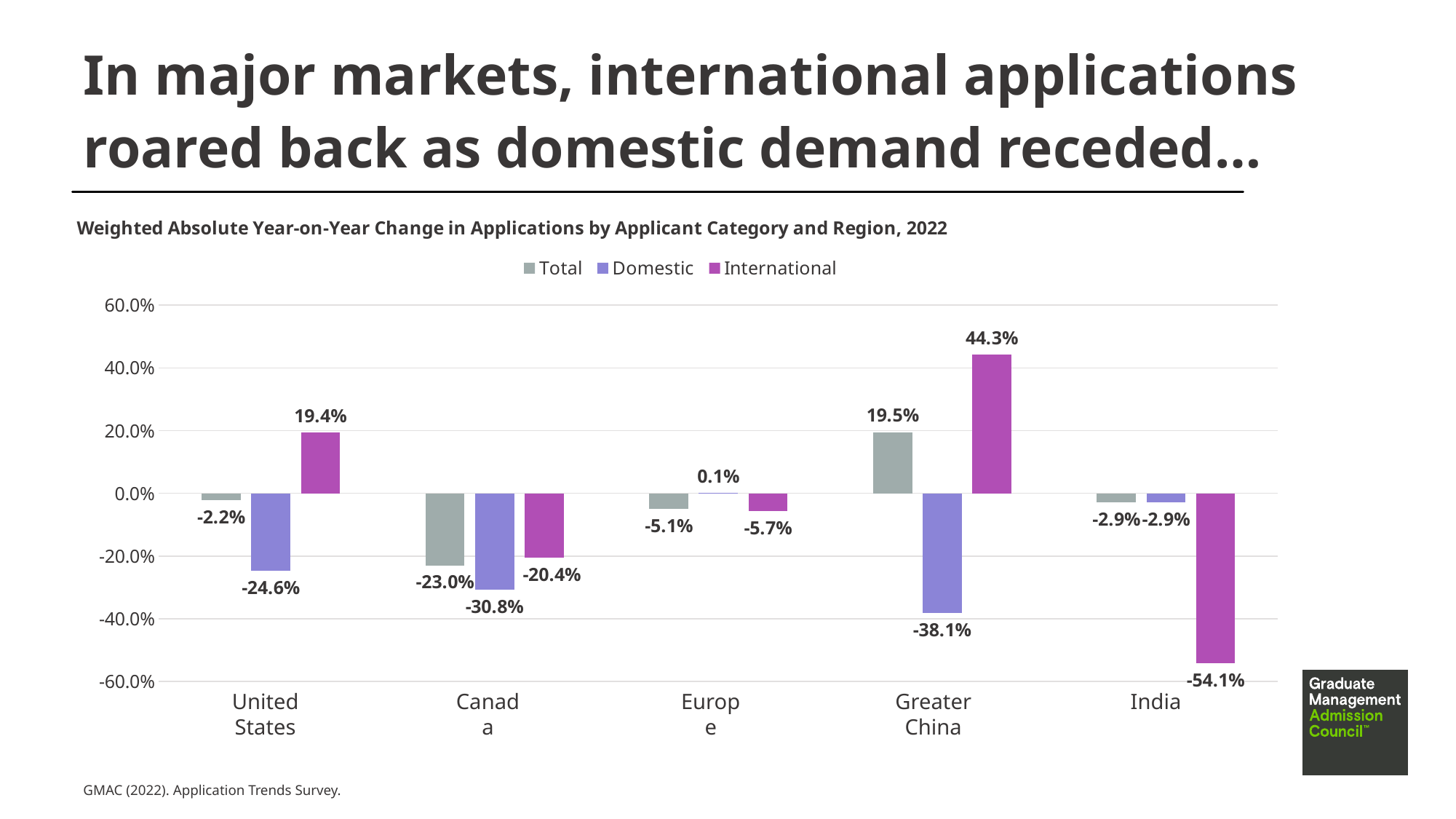
What is the difference between the International and Domestic values for Greater China? 82.4 percentage points Which region has the lowest Domestic value? Greater China What is the International value for Greater China? 44.3% Which region has the highest International value? Greater China What kind of chart is shown on the slide? Bar chart What is the International value for India? -54.1% How many regions are shown on the x axis? 5 What is the Domestic value for the United States? -24.6% Which series is shown in purple/magenta in the legend? International Which is larger, the Total value for the United States or the Total value for Greater China? Greater China How many series does the legend list? 3 What is the Total value for Canada? -23.0%